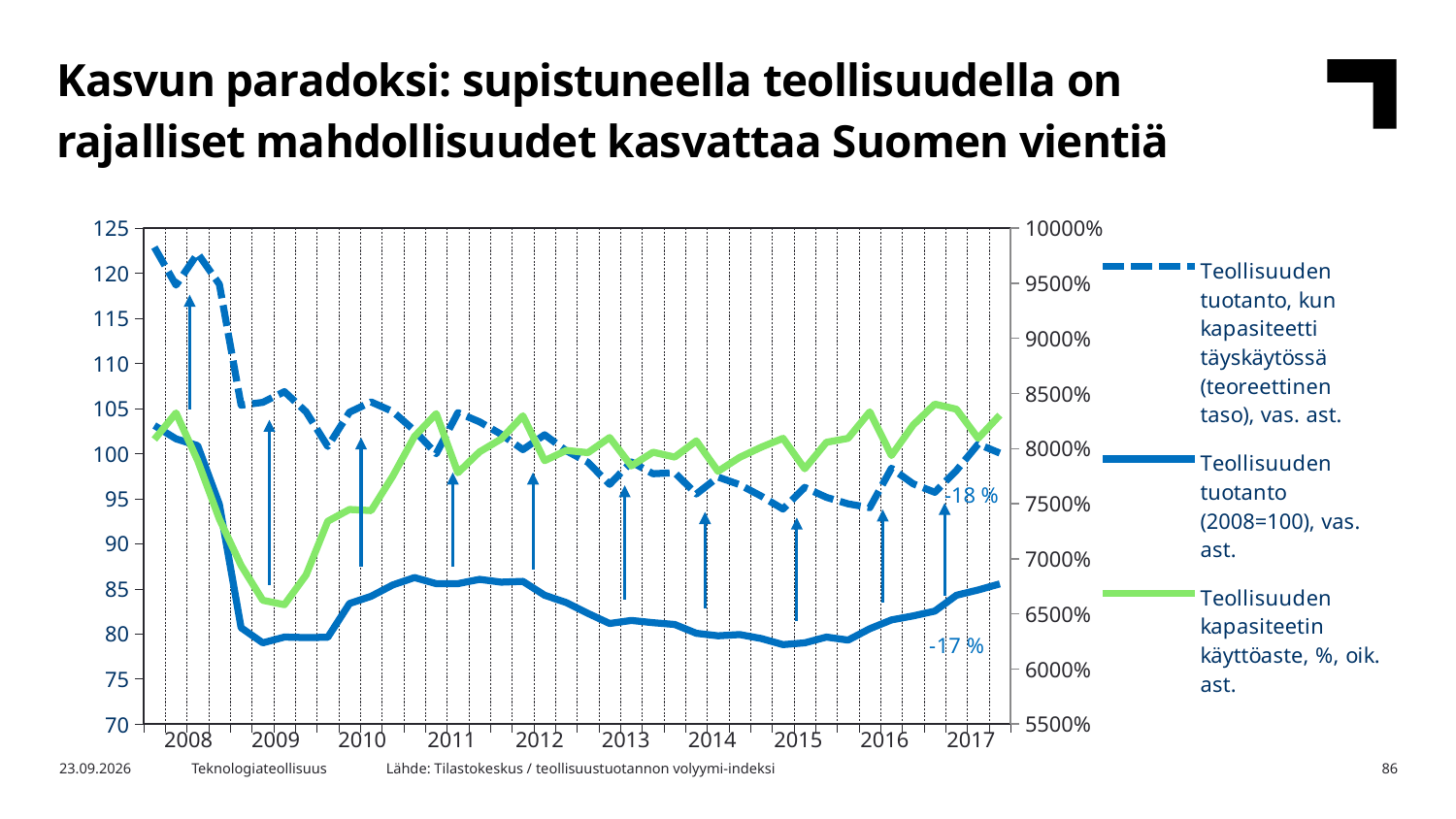
Is the value of the dashed blue line at the start of 2008 greater or less than 120 on the left axis? greater Does the solid blue line (Teollisuuden tuotanto, 2008=100) rise or fall from 2008 to 2009? fall What kind of chart is shown on the slide? line chart Is the value of the solid blue line (Teollisuuden tuotanto, 2008=100) in 2009 greater or less than 85 on the left axis? less Is the value of the solid blue line (Teollisuuden tuotanto, 2008=100) at the end of 2017 greater or less than 90 on the left axis? less How many series does the legend list? 3 What percentage change is annotated near the dashed line at the right end of the chart? -18 % Which series is drawn in green? Teollisuuden kapasiteetin käyttöaste, %, oik. ast. How many year labels are shown on the x axis? 10 In 2009, which is higher on the left axis: the dashed blue line or the solid blue line? the dashed blue line What percentage change is annotated near the solid blue line at the right end of the chart? -17 % Which year is the first label on the x axis? 2008